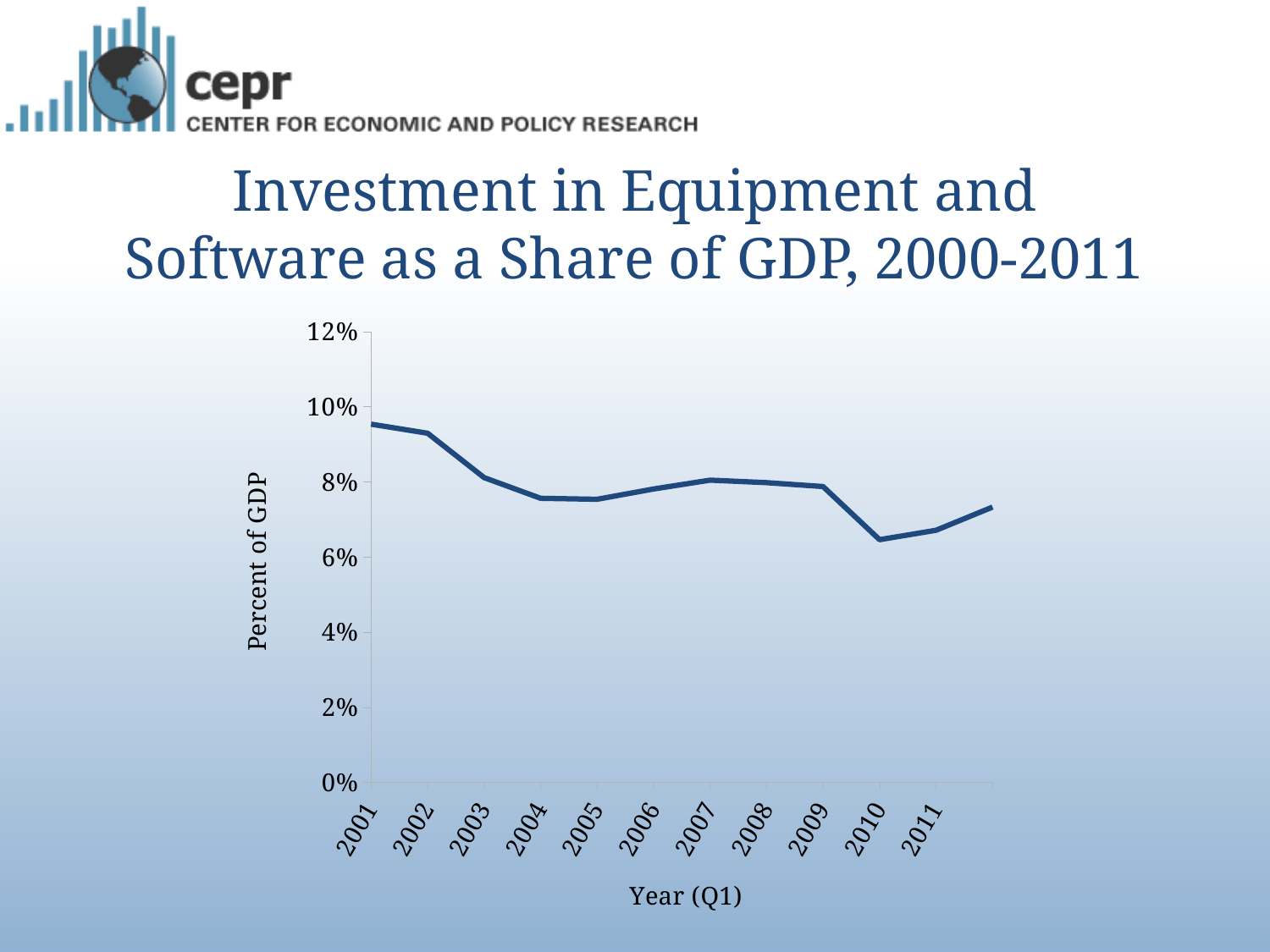
Which is larger, the value for 2010 or the value for 2001? 2001 Which is larger, the value for 2002 or the value for 2004? 2002 Does the value rise or fall from 2001 to 2010? fall Which labeled year has the lowest value? 2010 What is the title of the chart? Investment in Equipment and Software as a Share of GDP, 2000-2011 What is the label on the vertical axis? Percent of GDP Which labeled year has the highest value? 2001 Is the value for 2010 greater or less than 6%? greater Is the value for 2010 greater or less than 8%? less Is the value for 2001 greater or less than 8%? greater What kind of chart is shown on the slide? line chart